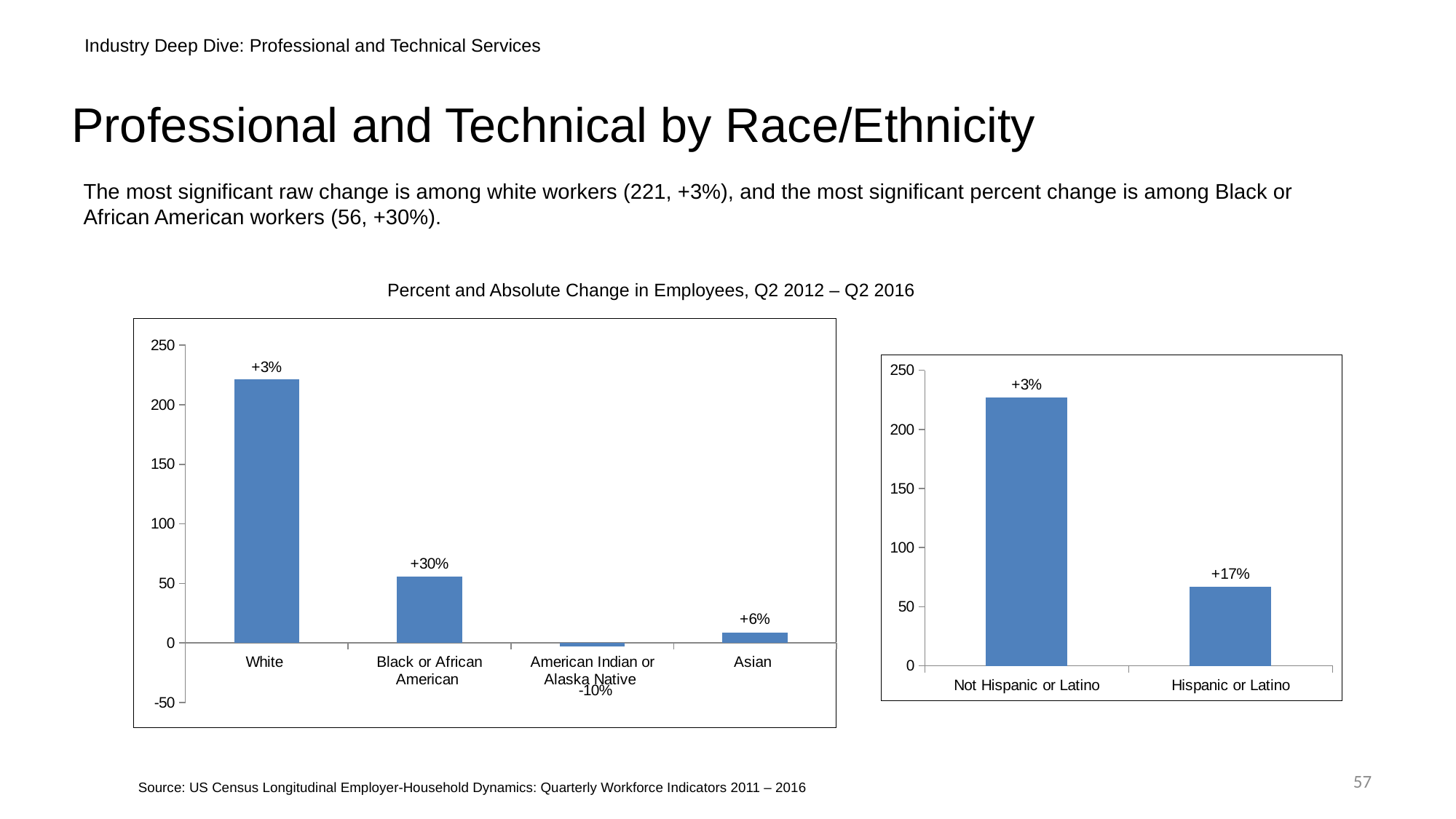
In the left chart (by race), what percent change label is shown above the bar for White? +3% In the left chart (by race), what percent change label is shown for American Indian or Alaska Native? -10% In the left chart (by race), is the bar for Black or African American greater or less than 100? less In the left chart (by race), which category has the tallest bar? White In the left chart (by race), what percent change label is shown for Asian? +6% In the left chart (by race), is the bar for White greater or less than 200? greater How many race categories are shown in the left chart? 4 In the left chart (by race), which category has the lowest bar? American Indian or Alaska Native In the right chart (by ethnicity), which category has the taller bar, Not Hispanic or Latino or Hispanic or Latino? Not Hispanic or Latino In the right chart (by ethnicity), what percent change label is shown for Hispanic or Latino? +17% In the left chart (by race), what percent change label is shown for Black or African American? +30% What type of chart is the right chart (by ethnicity)? Bar chart